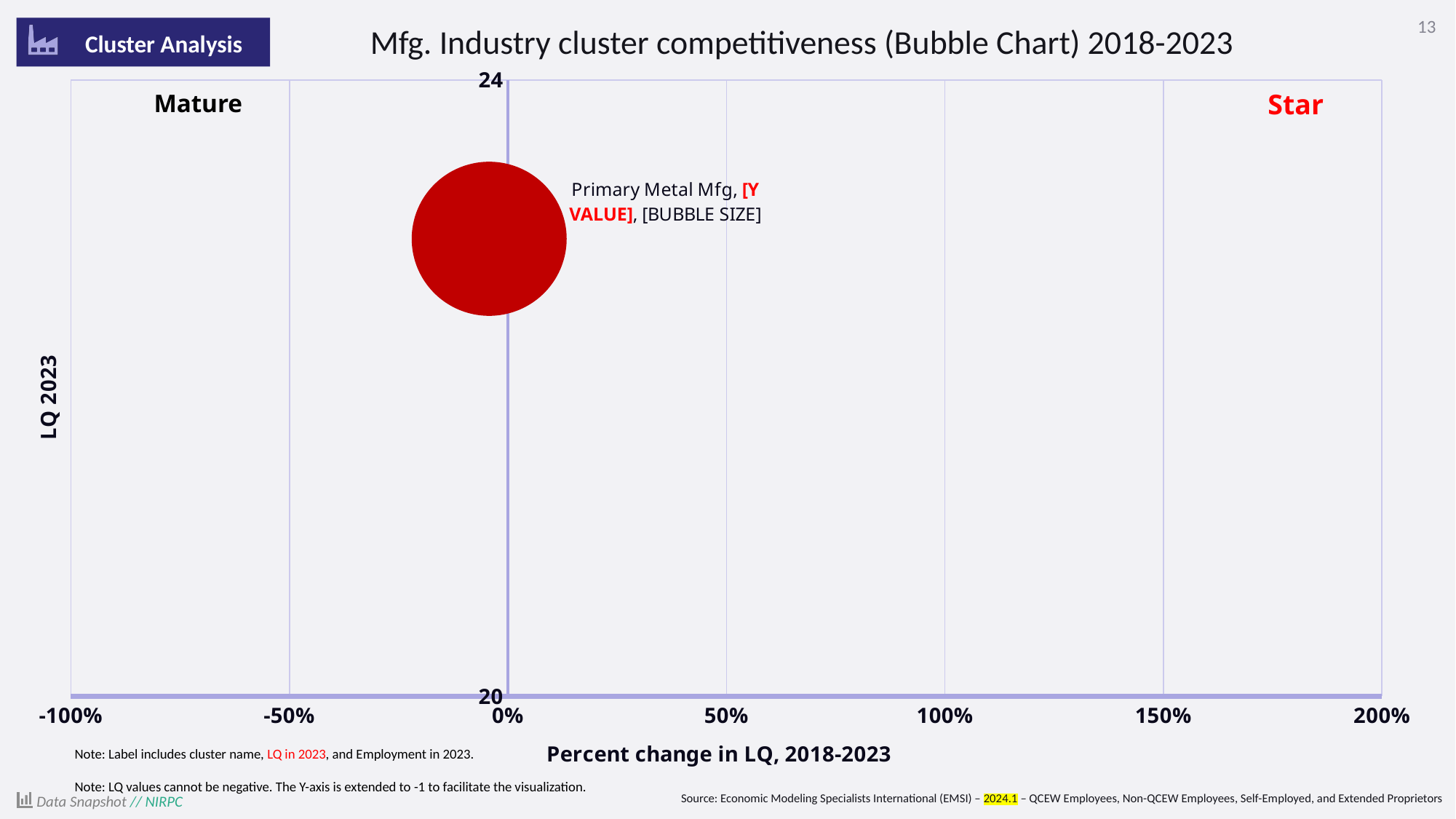
What is the maximum value shown on the y axis? 24 What quadrant label appears in the top-right corner of the chart? Star Is the percent change in LQ for Primary Metal Mfg greater or less than 50%? less Is the LQ 2023 value for Primary Metal Mfg greater or less than 22? greater What is the label of the y axis? LQ 2023 What kind of chart is shown on the slide? Bubble chart What is the label of the x axis? Percent change in LQ, 2018-2023 Is the percent change in LQ for Primary Metal Mfg greater or less than -50%? greater What is the title of the chart? Mfg. Industry cluster competitiveness (Bubble Chart) 2018-2023 What is the minimum value shown on the x axis? -100% Which cluster is plotted on the chart? Primary Metal Mfg How many bubbles are plotted on the chart? 1